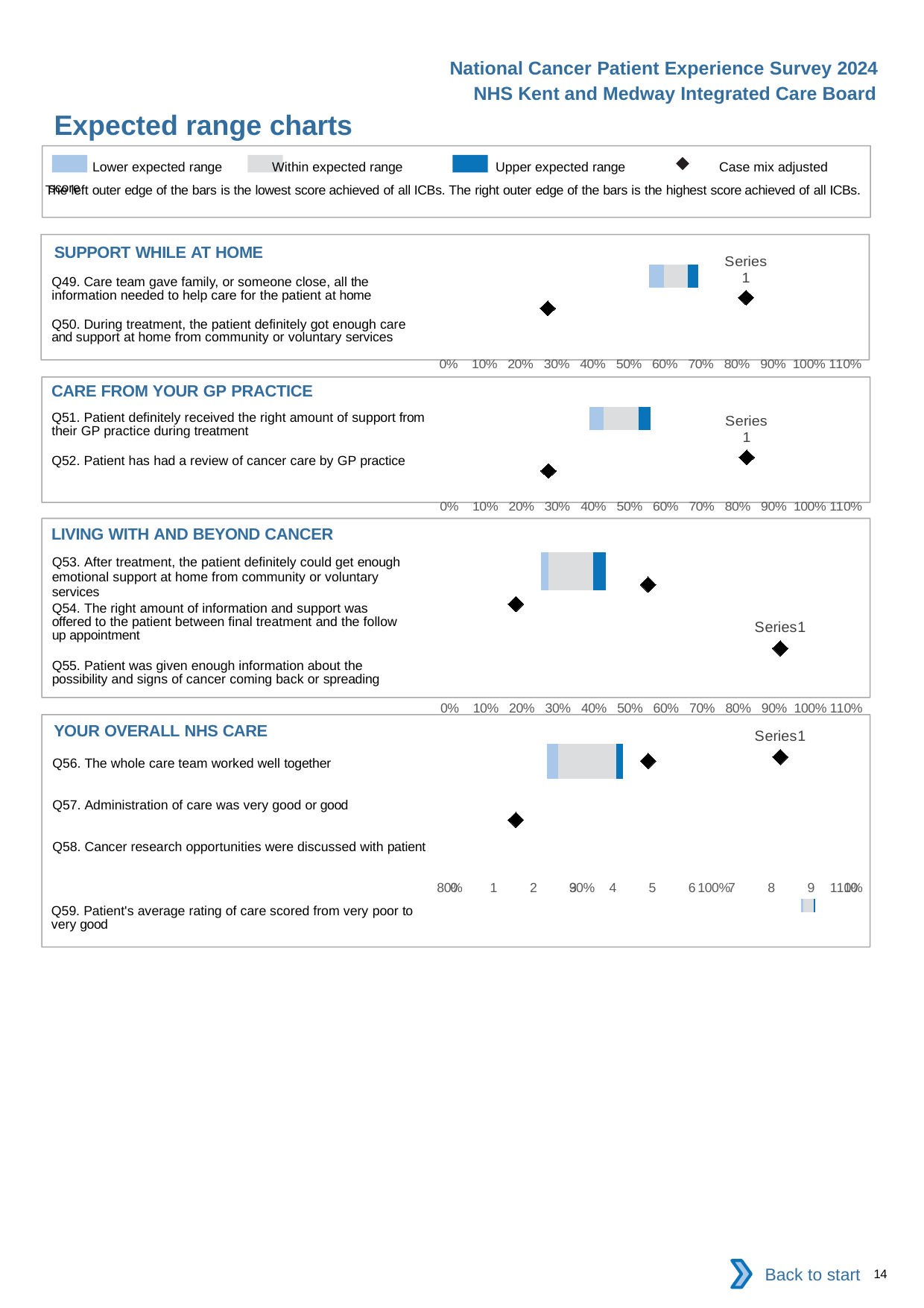
What is the highest tick label shown on the x axis of the CARE FROM YOUR GP PRACTICE chart? 110% In the LIVING WITH AND BEYOND CANCER chart, is the leftmost diamond marker greater or less than 40%? less How many questions are listed in the YOUR OVERALL NHS CARE section? 4 What is the title of the slide? Expected range charts How many questions are listed in the LIVING WITH AND BEYOND CANCER section? 3 How many questions are listed in the SUPPORT WHILE AT HOME section? 2 How many entries does the legend at the top of the slide list? 4 In the CARE FROM YOUR GP PRACTICE chart, is the leftmost diamond marker greater or less than 50%? less In the SUPPORT WHILE AT HOME chart, is the leftmost diamond marker greater or less than 50%? less What kind of chart is used in the SUPPORT WHILE AT HOME section? bar chart